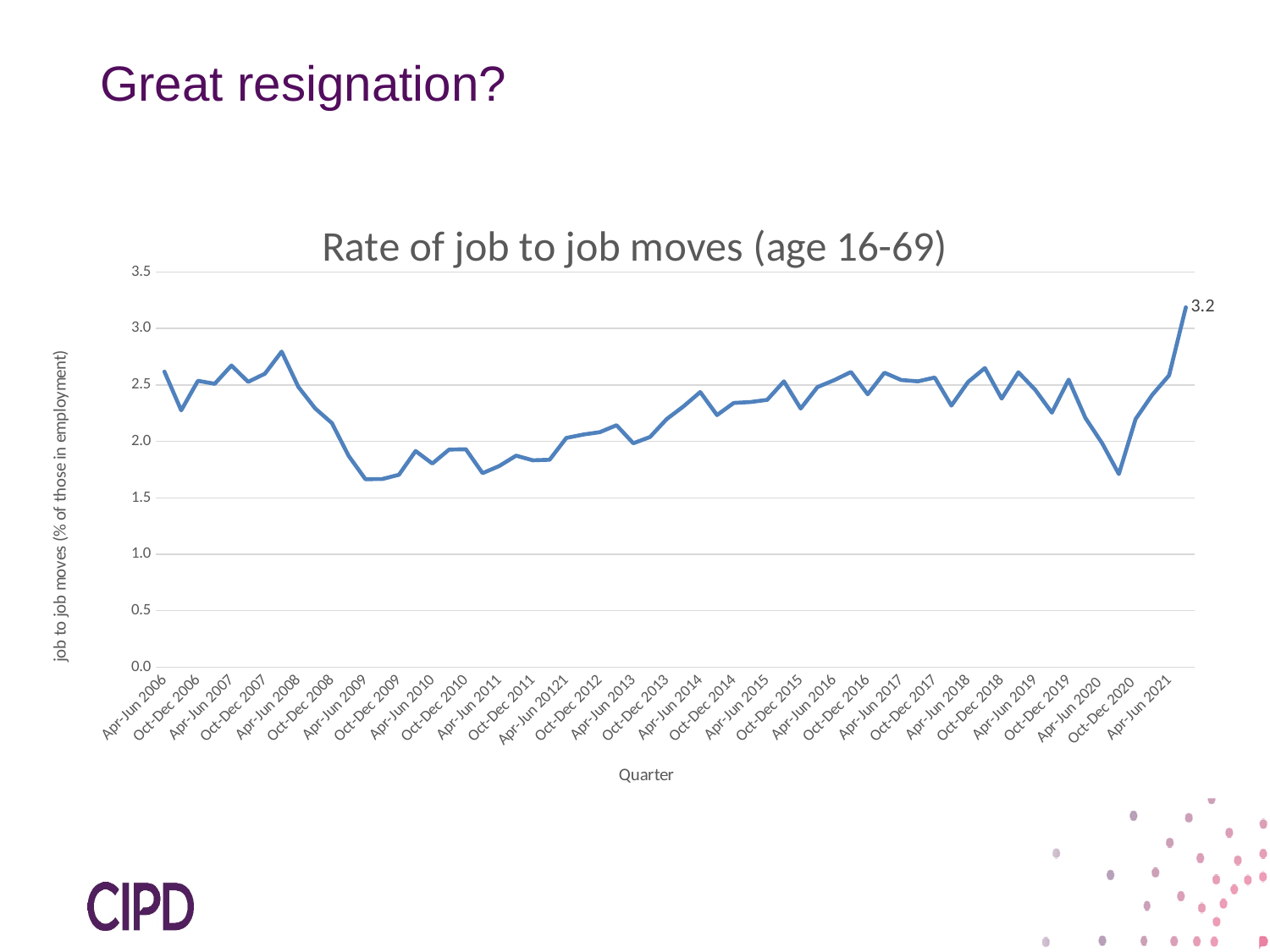
Is the value for Apr-Jun 2009 greater or less than 2.0? less Does the rate of job to job moves rise or fall between Apr-Jun 2008 and Apr-Jun 2009? fall What is the label of the x axis of the chart? Quarter What is the title of the chart? Rate of job to job moves (age 16-69) Is the value for Apr-Jun 2021 greater or less than 3.0? less Which quarter has the higher rate of job to job moves, Apr-Jun 2008 or Apr-Jun 2021? Apr-Jun 2021 Is the value for Oct-Dec 2020 greater or less than 2.0? greater Does the rate of job to job moves rise or fall between Oct-Dec 2020 and Apr-Jun 2021? rise What kind of chart is shown on the slide? line chart